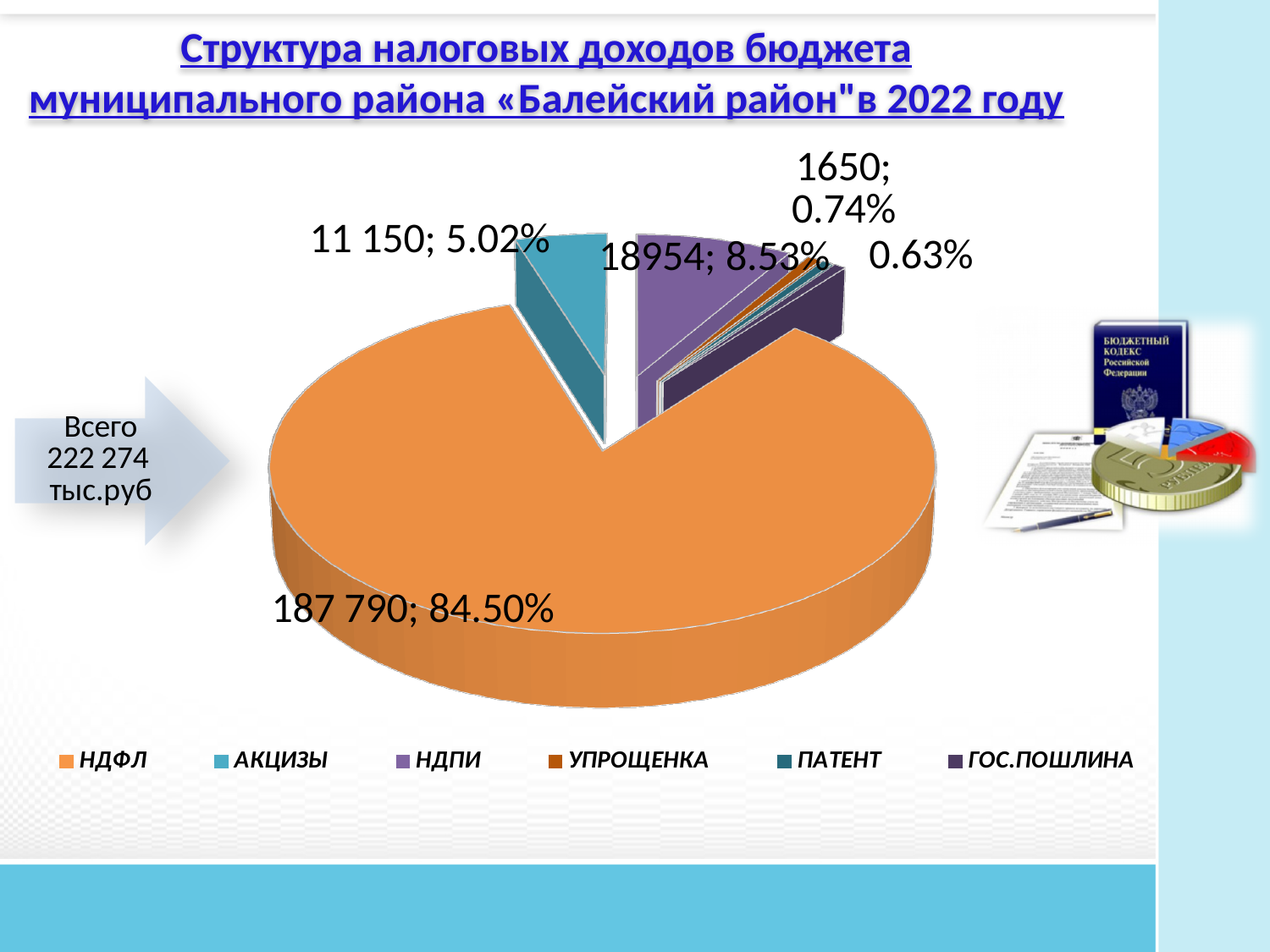
What value is shown for АКЦИЗЫ? 11 150 What is the difference between the values for НДПИ and АКЦИЗЫ? 7804 What value is shown for НДПИ? 18954 Which is larger, the value for АКЦИЗЫ or the value for НДПИ? НДПИ Which category has the largest slice of the pie? НДФЛ What share of the pie does НДФЛ account for? 84.50% How many categories does the legend list? 6 What value is shown for НДФЛ? 187 790 What kind of chart is shown on the slide? Pie chart What share of the pie does НДПИ account for? 8.53% What total amount is stated in the arrow to the left of the chart? 222 274 тыс.руб What share of the pie does АКЦИЗЫ account for? 5.02%